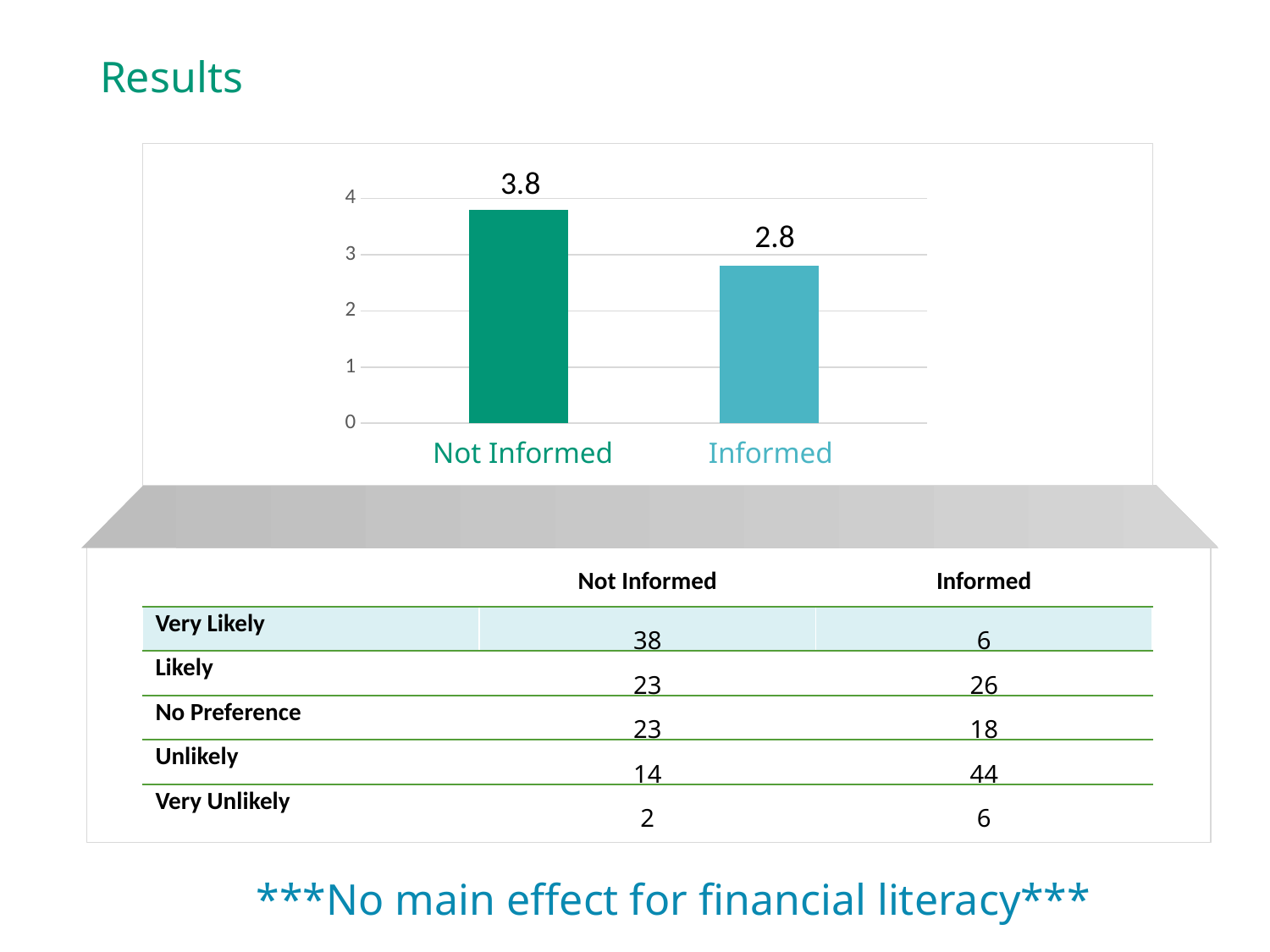
What is the title of the slide containing the chart? Results What kind of chart is shown on the slide? bar chart Is the value for Not Informed greater or less than 3? greater What is the value for Not Informed? 3.8 Which is larger, the value for Not Informed or the value for Informed? Not Informed Which category has the lowest value? Informed How many categories are shown in the chart? 2 Is the value for Informed greater or less than 3? less Which category has the highest value? Not Informed What is the highest value shown on the vertical axis? 4 What is the value for Informed? 2.8 What is the difference between the values for Not Informed and Informed? 1.0